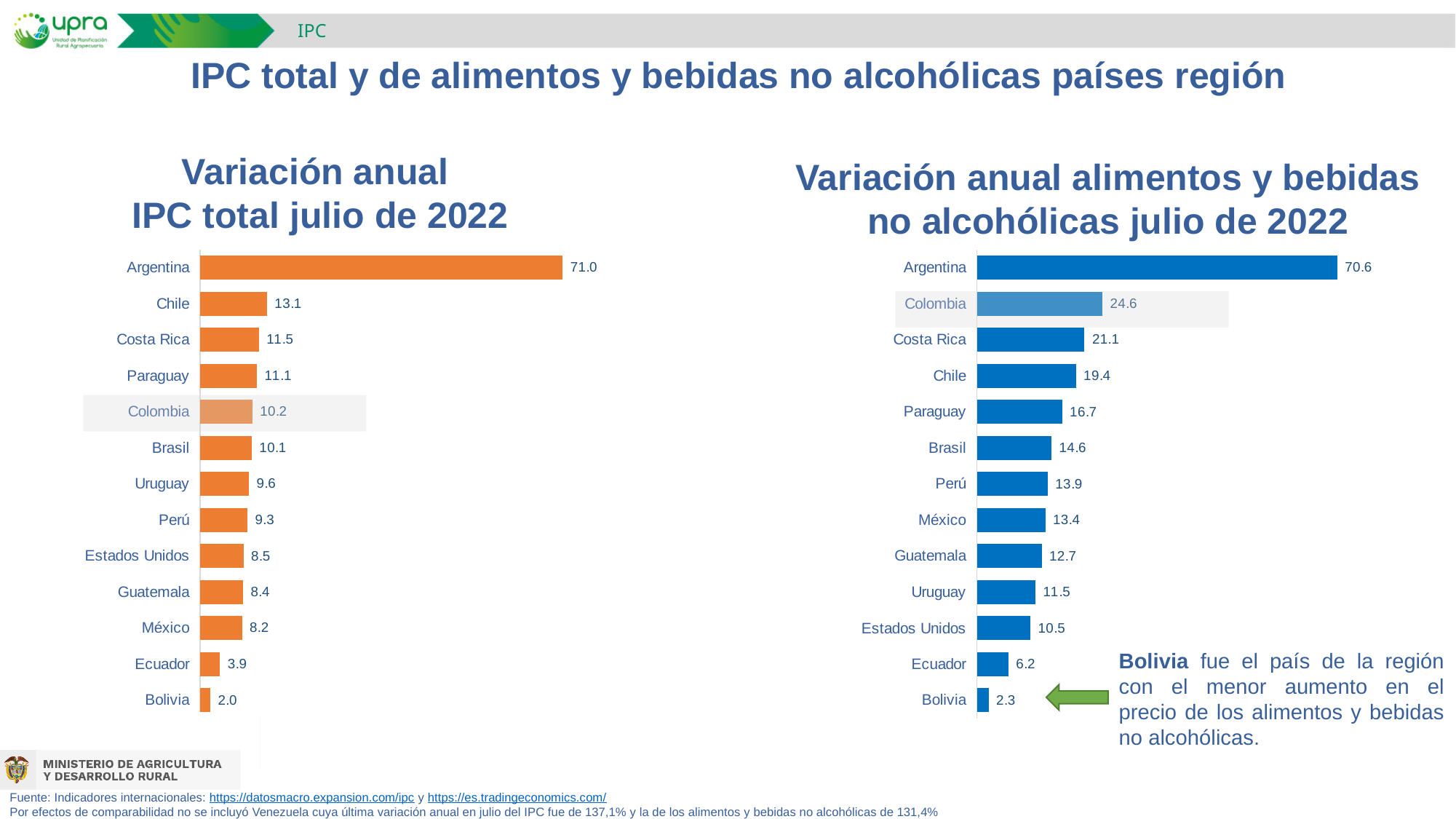
In the 'Variación anual IPC total julio de 2022' chart, what is the value for Chile? 13.1 In the 'Variación anual IPC total julio de 2022' chart, what is the difference between the values for Argentina and Chile? 57.9 In the 'Variación anual IPC total julio de 2022' chart, which is larger, the value for Paraguay or the value for Brasil? Paraguay How many countries are shown in the 'Variación anual IPC total julio de 2022' chart? 13 How many countries are shown in the 'Variación anual alimentos y bebidas no alcohólicas julio de 2022' chart? 13 In the 'Variación anual alimentos y bebidas no alcohólicas julio de 2022' chart, what is the difference between the values for Colombia and Costa Rica? 3.5 In the 'Variación anual IPC total julio de 2022' chart, which country has the highest value? Argentina In the 'Variación anual alimentos y bebidas no alcohólicas julio de 2022' chart, which country has the lowest value? Bolivia In the 'Variación anual IPC total julio de 2022' chart, what is the value for Estados Unidos? 8.5 In the 'Variación anual alimentos y bebidas no alcohólicas julio de 2022' chart, which is larger, the value for Uruguay or the value for Guatemala? Guatemala What kind of chart is the 'Variación anual IPC total julio de 2022' chart? Bar chart In the 'Variación anual alimentos y bebidas no alcohólicas julio de 2022' chart, what is the value for Colombia? 24.6